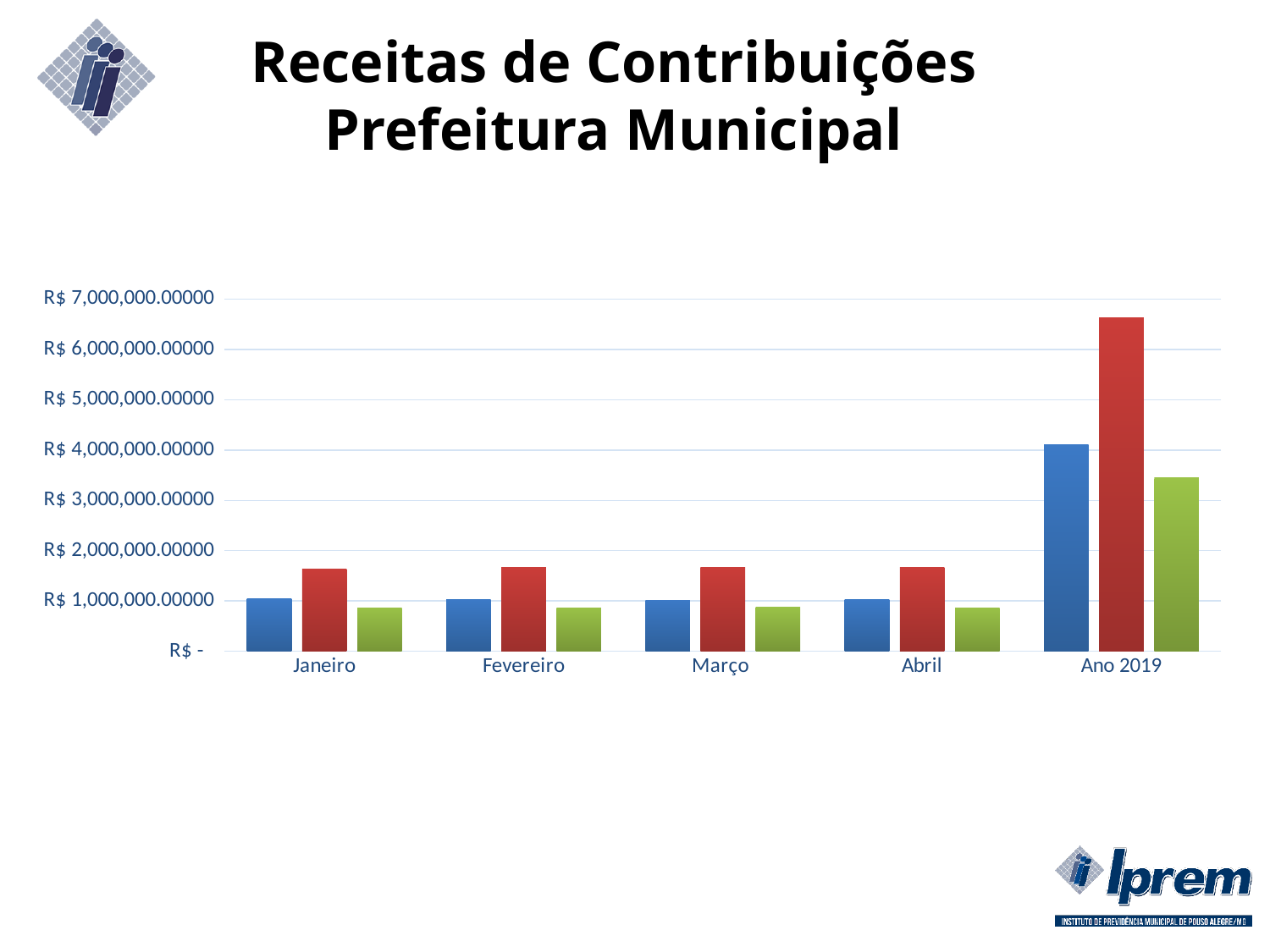
Is the value of the green bar for Abril greater or less than R$ 1,000,000.00000? less For Ano 2019, which bar is larger, the blue bar or the green bar? the blue bar Is the value of the red bar for Janeiro greater or less than R$ 1,000,000.00000? greater Which category has the tallest bars in the chart? Ano 2019 How many bars are plotted for each category in the chart? 3 What kind of chart is shown on the slide? bar chart In Março, which bar is larger, the red bar or the green bar? the red bar How many categories are shown on the x axis of the chart? 5 Is the value of the green bar for Ano 2019 greater or less than R$ 4,000,000.00000? less What is the title of the slide containing the chart? Receitas de Contribuições Prefeitura Municipal